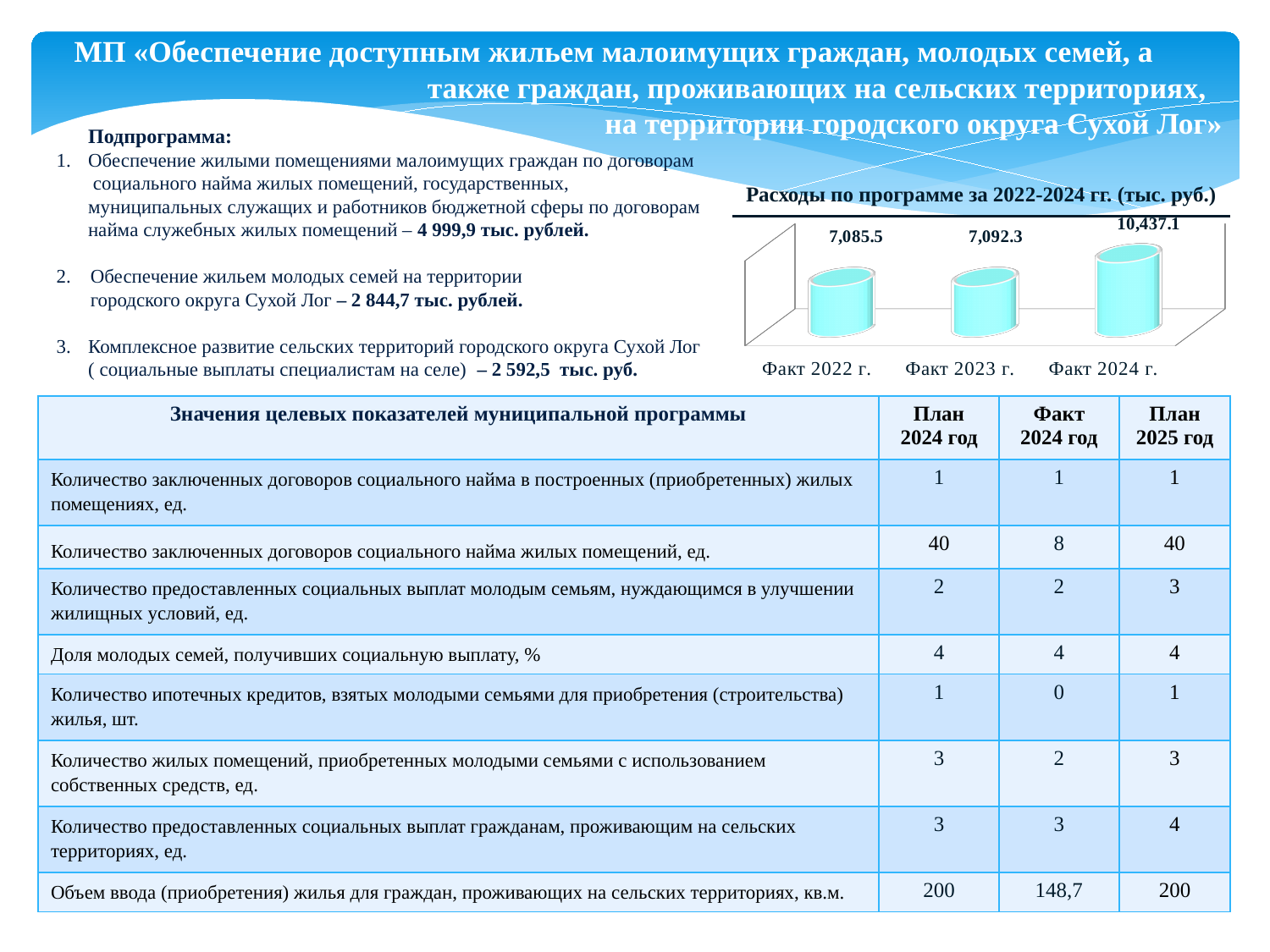
What is the value for Факт 2023 г. in the chart «Расходы по программе за 2022-2024 гг. (тыс. руб.)»? 7,092.3 Do the values in the chart «Расходы по программе за 2022-2024 гг. (тыс. руб.)» rise or fall from Факт 2022 г. to Факт 2024 г.? Rise In the chart «Расходы по программе за 2022-2024 гг. (тыс. руб.)», which is larger: the value for Факт 2024 г. or Факт 2022 г.? Факт 2024 г. What is the value for Факт 2024 г. in the chart «Расходы по программе за 2022-2024 гг. (тыс. руб.)»? 10,437.1 What kind of chart is «Расходы по программе за 2022-2024 гг. (тыс. руб.)»? Bar chart Which category has the lowest value in the chart «Расходы по программе за 2022-2024 гг. (тыс. руб.)»? Факт 2022 г. In the chart «Расходы по программе за 2022-2024 гг. (тыс. руб.)», what is the difference between the values for Факт 2024 г. and Факт 2022 г.? 3,351.6 Which category has the highest value in the chart «Расходы по программе за 2022-2024 гг. (тыс. руб.)»? Факт 2024 г. What is the value for Факт 2022 г. in the chart «Расходы по программе за 2022-2024 гг. (тыс. руб.)»? 7,085.5 How many categories are shown in the chart «Расходы по программе за 2022-2024 гг. (тыс. руб.)»? 3 In the chart «Расходы по программе за 2022-2024 гг. (тыс. руб.)», what is the difference between the values for Факт 2024 г. and Факт 2023 г.? 3,344.8 In what units are the values of the chart «Расходы по программе за 2022-2024 гг.» given, according to its title? тыс. руб.